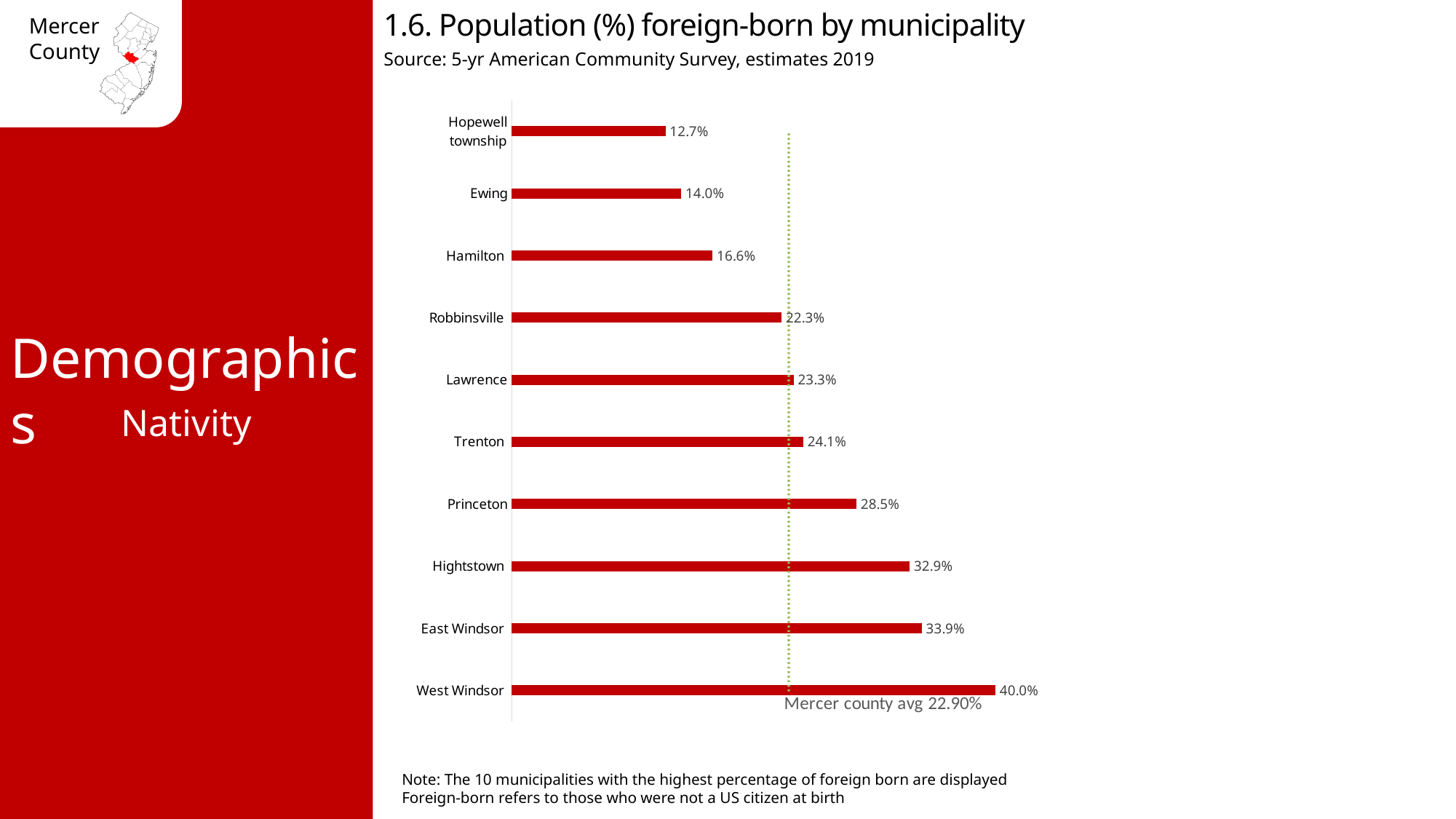
Which municipality has the lowest percentage of foreign-born population? Hopewell township What is the source of the data shown in the chart? 5-yr American Community Survey, estimates 2019 What is the difference in foreign-born percentage between West Windsor and Hopewell township? 27.3% What is the foreign-born population percentage for West Windsor? 40.0% What is the foreign-born population percentage for Hamilton? 16.6% What is the difference in foreign-born percentage between East Windsor and Hightstown? 1.0% How many municipalities are shown in the chart? 10 What is the foreign-born population percentage for Trenton? 24.1% Which municipality has the highest percentage of foreign-born population? West Windsor Which has a higher foreign-born percentage, Princeton or Robbinsville? Princeton What is the Mercer county average foreign-born percentage shown by the dotted line? 22.90% What type of chart is used on this slide? Bar chart